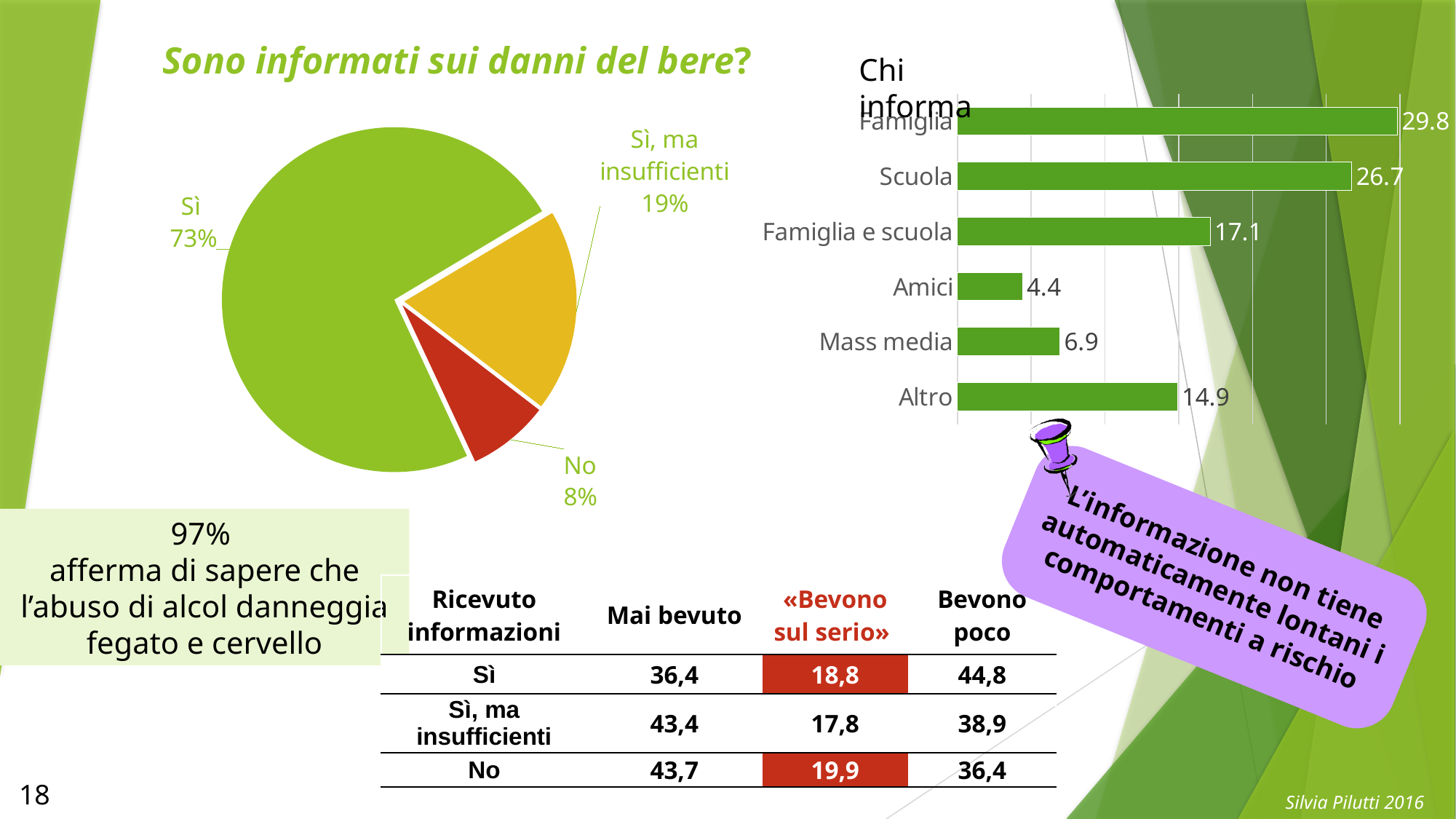
What kind of chart is the "Chi informa" chart on the right? Bar chart In the pie chart on the left, how many slices are there? 3 In the pie chart on the left, what share of respondents answered "No"? 8% In the pie chart on the left, what share answered "Sì, ma insufficienti"? 19% In the pie chart on the left, what share of respondents answered "Sì"? 73% In the pie chart on the left, which answer has the smallest slice? No In the "Chi informa" bar chart, which category has the lowest value? Amici In the "Chi informa" bar chart, which is larger, Altro or Mass media? Altro In the "Chi informa" bar chart, what is the difference between Scuola and Famiglia e scuola? 9.6 In the "Chi informa" bar chart, what is the value for Mass media? 6.9 In the "Chi informa" bar chart, which category has the highest value? Famiglia In the "Chi informa" bar chart, what is the value for Famiglia? 29.8